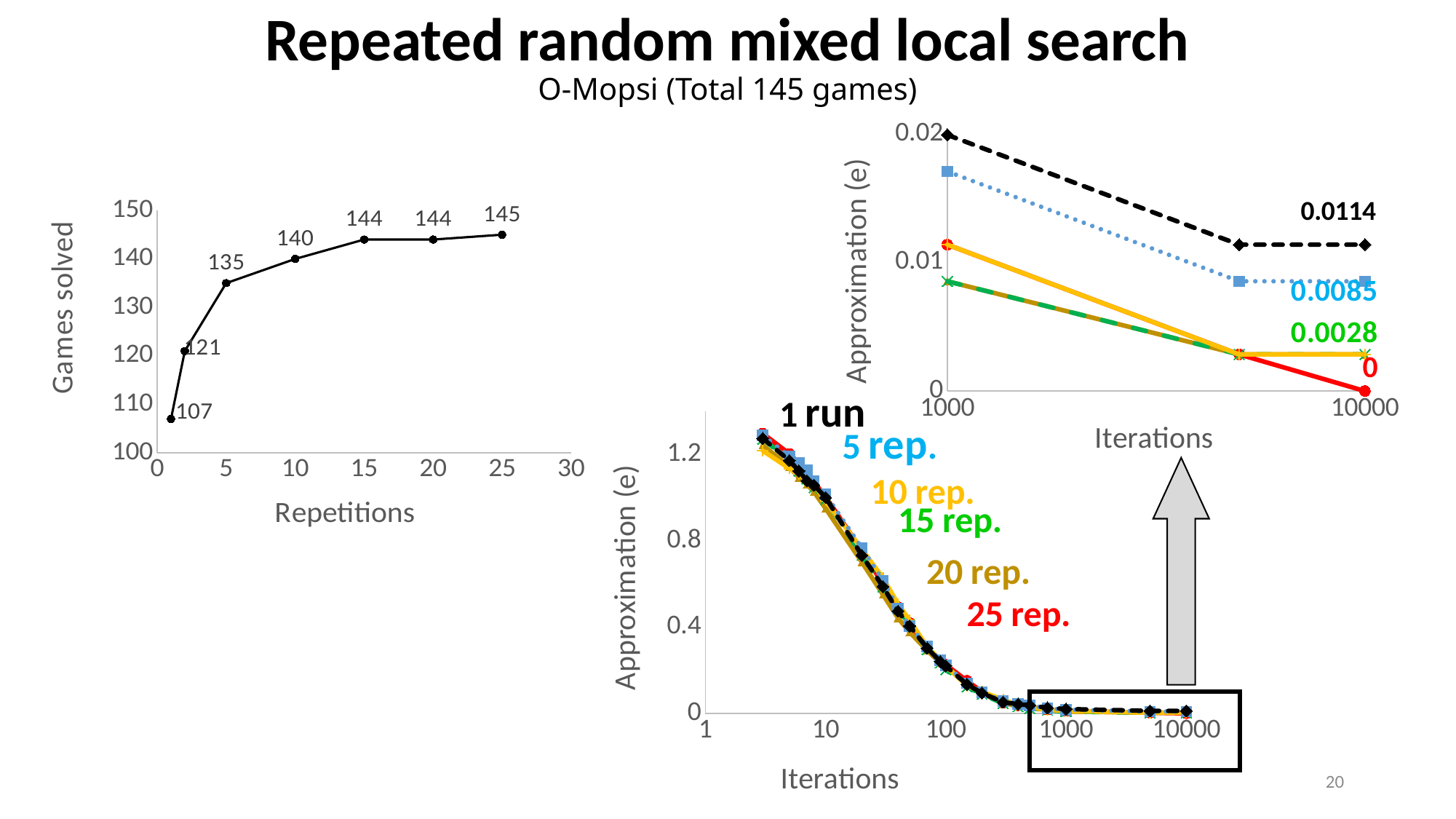
How many series are labelled in the bottom-right chart of approximation versus iterations? 6 In the top-right zoomed chart of approximation versus iterations, what is the labelled value of the black dashed 1 run series at 10000 iterations? 0.0114 In the left chart of games solved versus repetitions, how many games are solved at 25 repetitions? 145 In the left chart of games solved versus repetitions, how many data points are plotted? 7 In the left chart of games solved versus repetitions, what is the lowest number of games solved shown? 107 In the left chart of games solved versus repetitions, what is the difference in games solved between 10 repetitions and 1 repetition? 33 In the top-right zoomed chart of approximation versus iterations, what is the labelled value of the blue 5 rep. series at 10000 iterations? 0.0085 In the left chart of games solved versus repetitions, do the values rise or fall as repetitions increase? rise What type of chart is the left chart of games solved versus repetitions? line chart In the top-right zoomed chart of approximation versus iterations, which series reaches the lowest labelled value at 10000 iterations? 25 rep. (red) In the left chart of games solved versus repetitions, is the value at 2 repetitions greater or less than 130? less In the left chart of games solved versus repetitions, how many games are solved at 5 repetitions? 135